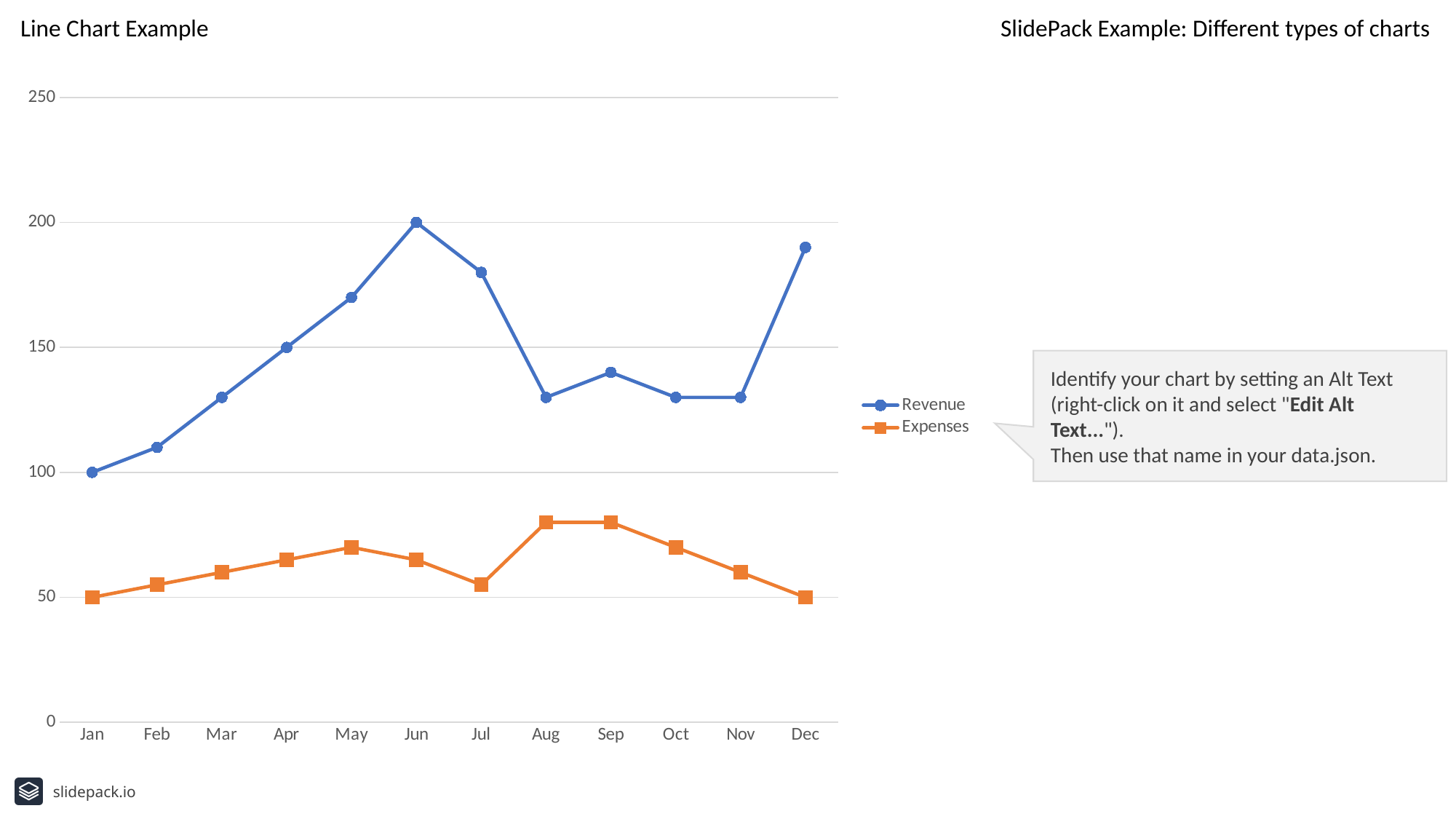
In which month is Revenue highest? Jun What is the title of the chart? Line Chart Example How many months are plotted along the x axis? 12 What is the difference between Revenue in Jun and Revenue in Jan? 100 What is the Revenue value for Jan? 100 Is the Revenue value for Dec greater or less than 150? greater Does Revenue rise or fall from Jan to Jun? rise How many series does the legend list? 2 What type of chart is shown on the slide? line chart In which month is Revenue lowest? Jan What is the Revenue value for Jun? 200 What is the Expenses value for Jan? 50